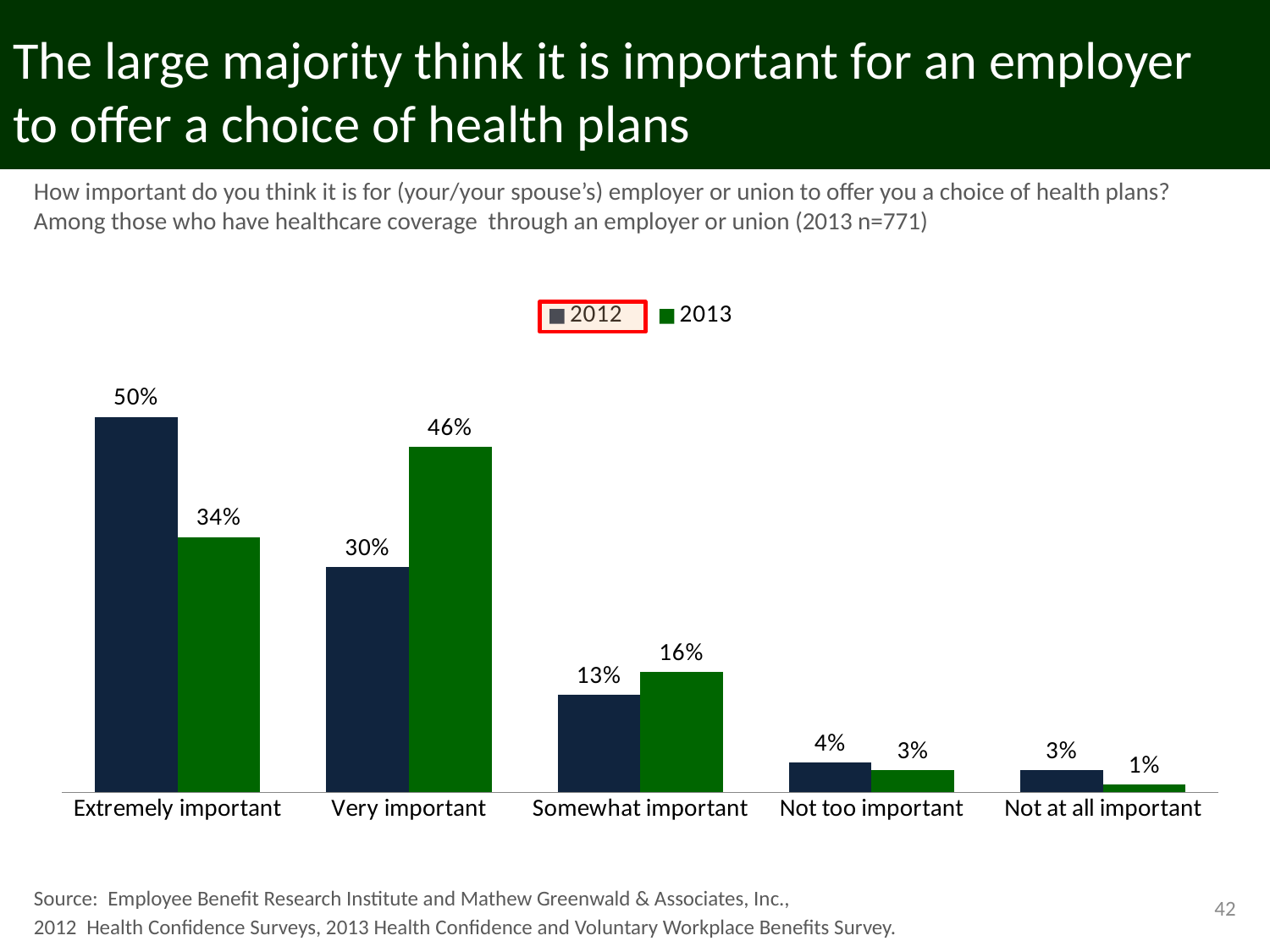
How many categories are shown on the x axis? 5 What is the difference between the 2012 and 2013 values for "Extremely important"? 16% What is the 2012 value for "Extremely important"? 50% How many series does the legend list? 2 What is the 2012 value for "Not at all important"? 3% What is the 2013 value for "Very important"? 46% Which legend entry is highlighted with a red box? 2012 What kind of chart is shown on the slide? Bar chart Which category has the highest 2013 value? Very important What is the 2013 value for "Somewhat important"? 16% Which is larger for "Very important": the 2012 value or the 2013 value? 2013 Which category has the lowest 2012 value? Not at all important